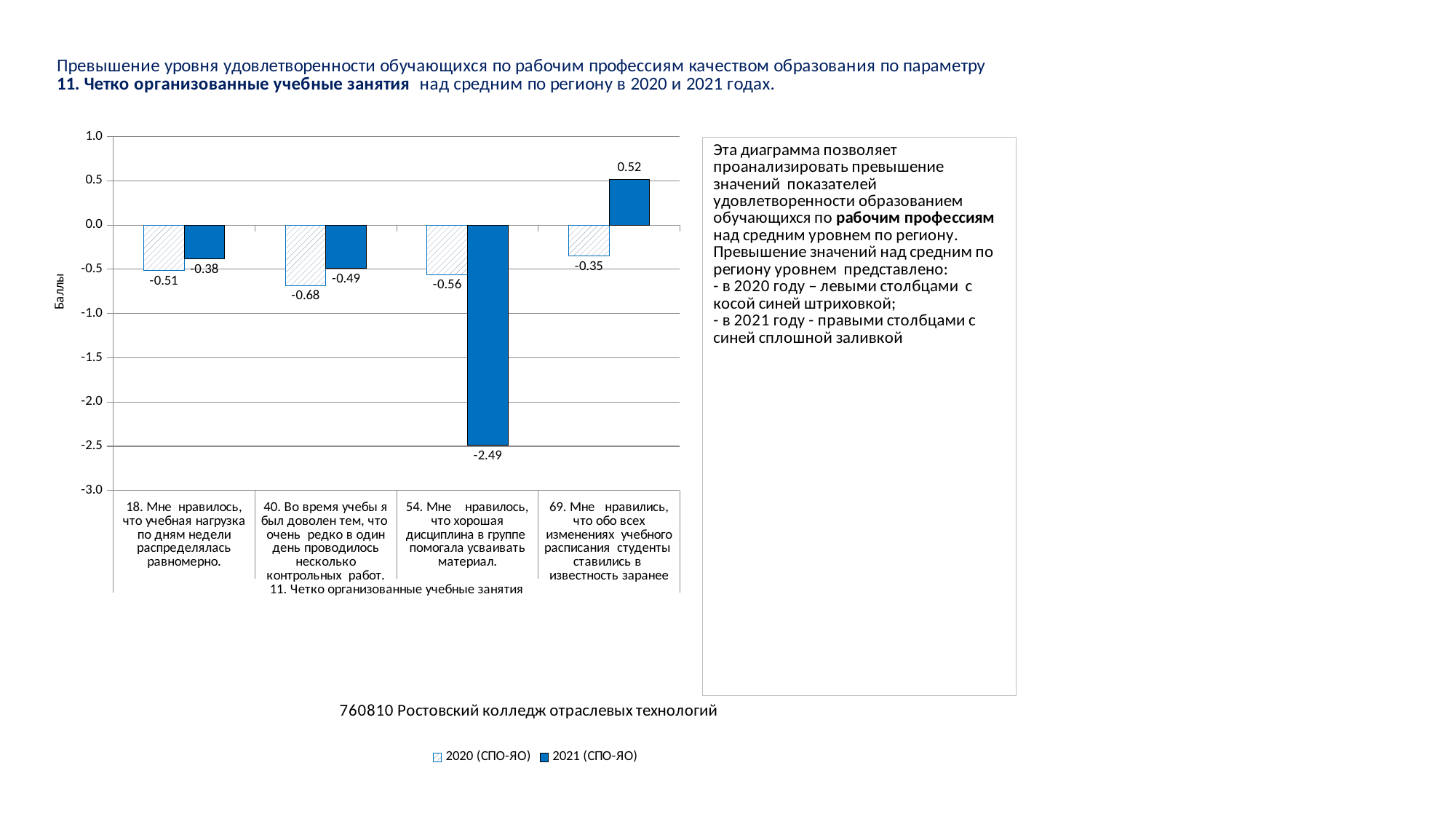
Which item has the highest 2020 (СПО-ЯО) value? 69. Мне нравились, что обо всех изменениях учебного расписания студенты ставились в известность заранее What is the 2020 (СПО-ЯО) value for item 40 (Во время учебы я был доволен тем, что очень редко в один день проводилось несколько контрольных работ)? -0.68 What is the label of the vertical axis? Баллы Which item has the lowest 2021 (СПО-ЯО) value? 54. Мне нравилось, что хорошая дисциплина в группе помогала усваивать материал. How many series does the legend list? 2 For item 40, which is larger: the 2020 value or the 2021 value? 2021 (-0.49) What is the 2020 (СПО-ЯО) value for item 18 (Мне нравилось, что учебная нагрузка по дням недели распределялась равномерно)? -0.51 What is the difference between the 2021 and 2020 values for item 69? 0.87 What is the 2021 (СПО-ЯО) value for item 69 (Мне нравились, что обо всех изменениях учебного расписания студенты ставились в известность заранее)? 0.52 What type of chart is shown on the slide? Bar chart How many items (categories) are shown on the x axis? 4 What is the 2021 (СПО-ЯО) value for item 54 (Мне нравилось, что хорошая дисциплина в группе помогала усваивать материал)? -2.49